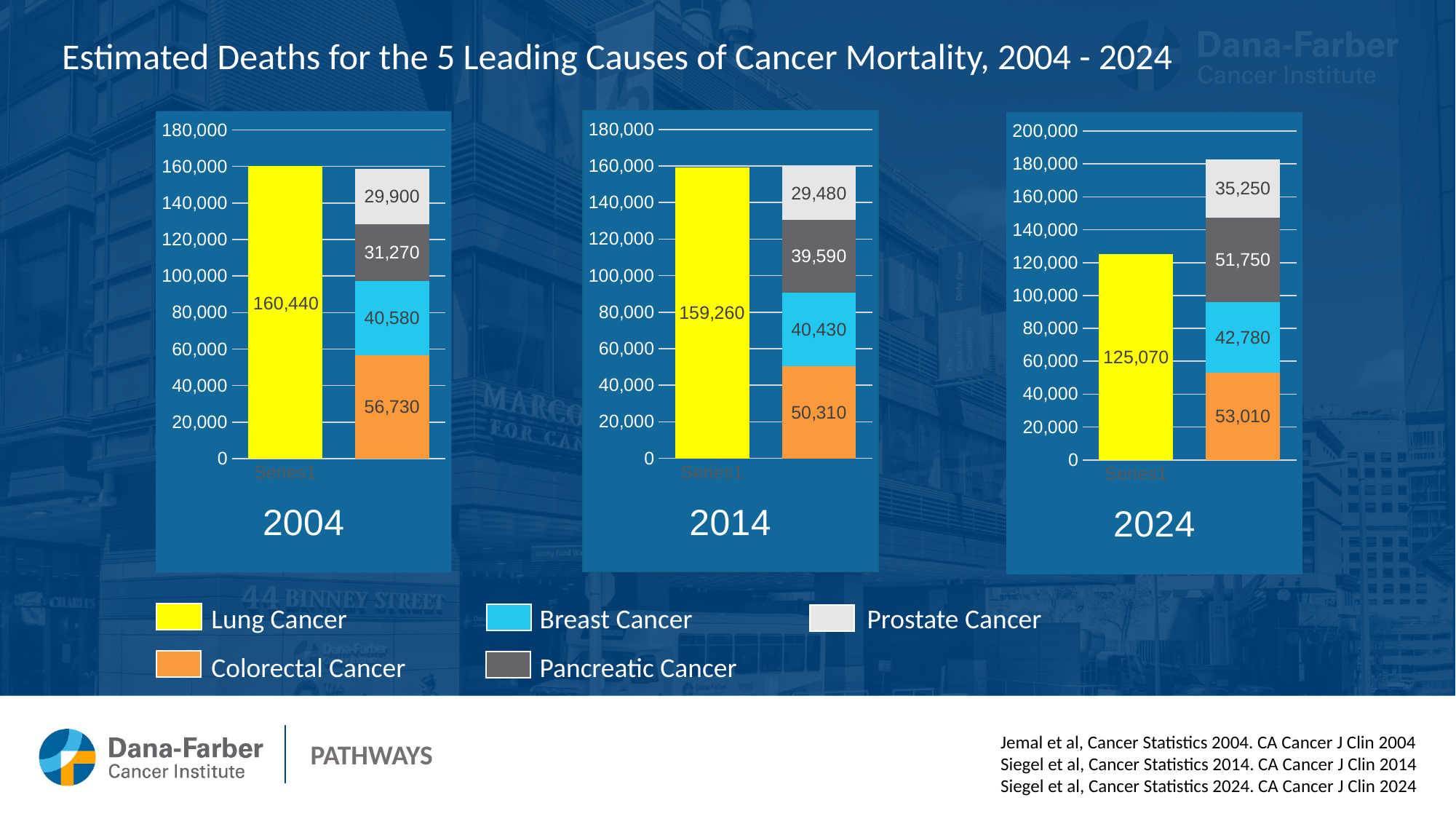
In the 2024 chart, which cancer has the highest estimated deaths? Lung Cancer Across the three charts, do Lung Cancer deaths rise or fall from 2004 to 2024? Fall In the 2004 chart, what is the value for Lung Cancer? 160,440 What kind of chart is used on this slide? Bar chart In the 2004 chart, which cancer has the lowest estimated deaths? Prostate Cancer In the 2004 chart, what is the total of the stacked bar (Colorectal, Breast, Pancreatic and Prostate Cancer)? 158,480 In the 2014 chart, what is the value for Pancreatic Cancer? 39,590 In the 2024 chart, what is the value for Prostate Cancer? 35,250 How many series does the legend list? 5 In the 2014 chart, what is the difference between Colorectal Cancer and Breast Cancer deaths? 9,880 In the 2024 chart, which is larger, Pancreatic Cancer or Colorectal Cancer? Colorectal Cancer In the 2024 chart, what is the total of the stacked bar (Colorectal, Breast, Pancreatic and Prostate Cancer)? 182,790